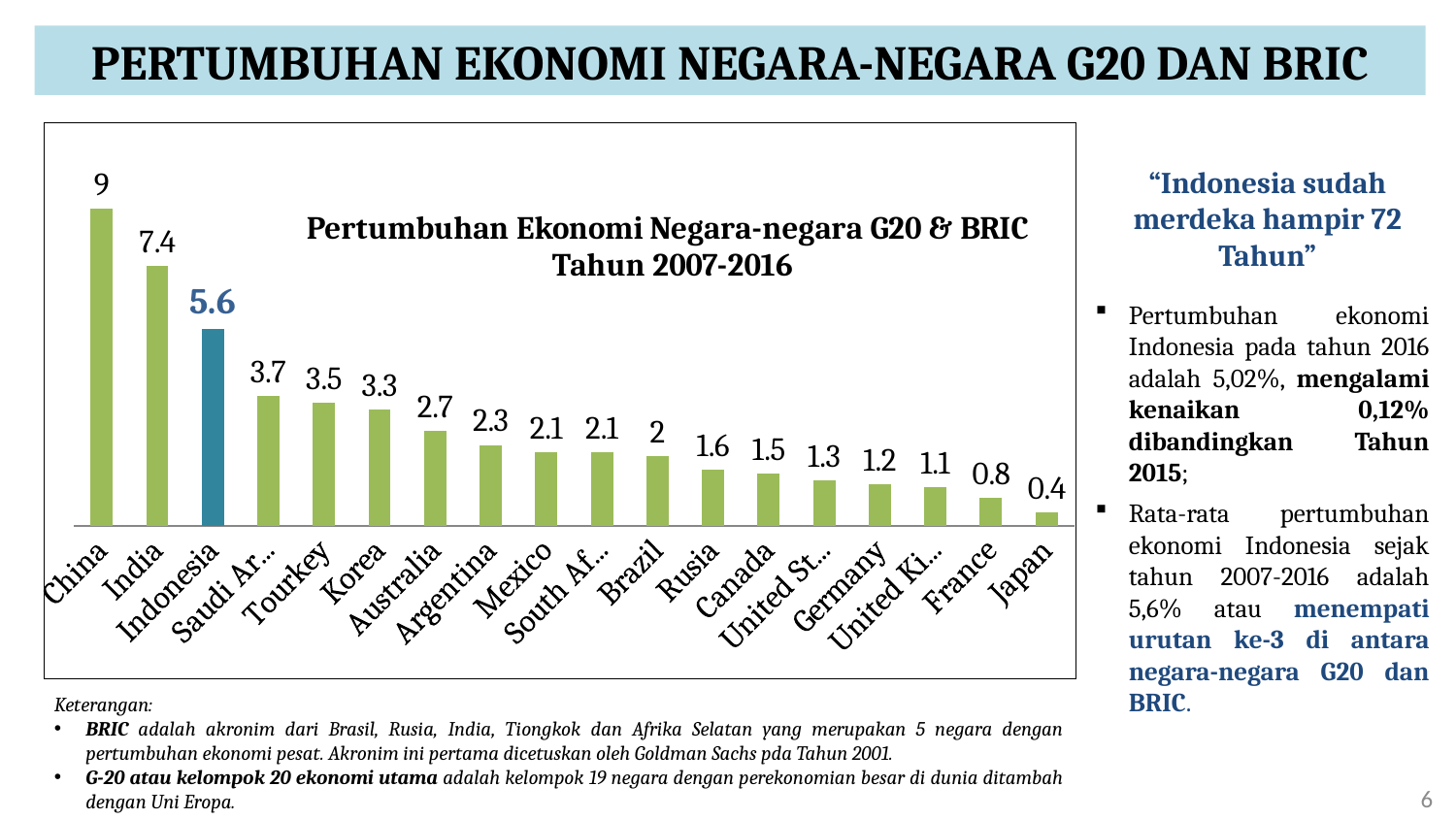
What is the value for Japan? 0.4 Which is larger, the value for Korea or the value for Canada? Korea What is the value for Australia? 2.7 What is the difference between the values for China and India? 1.6 How many countries are shown in the chart? 18 What is the difference between the values for Indonesia and Brazil? 3.6 Do the values rise or fall from left to right along the x axis? fall What type of chart is shown on the slide? bar chart Which country has the highest value? China Which country has the lowest value? Japan What is the value for China? 9 What is the value for Indonesia? 5.6